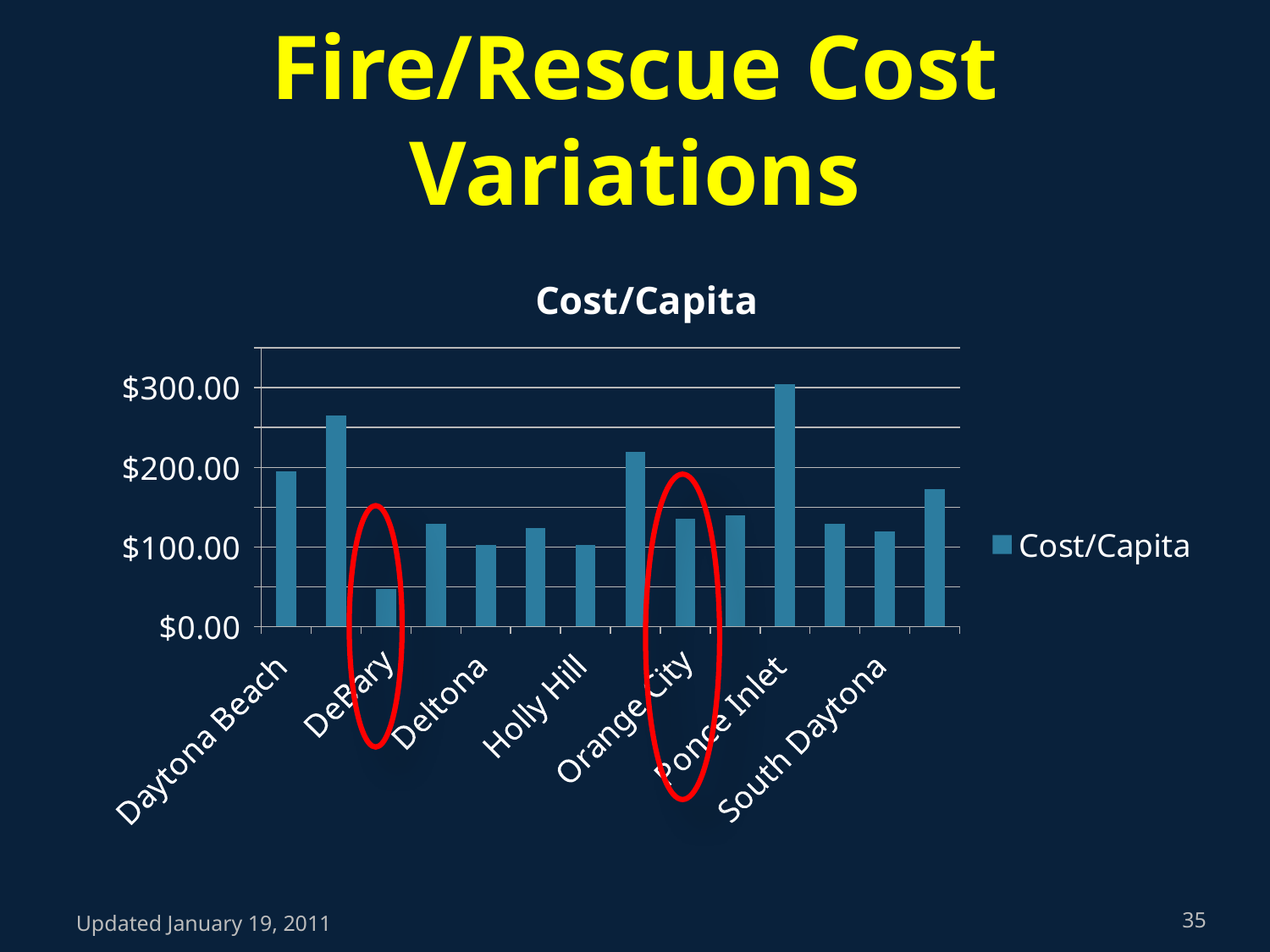
How many bars are plotted in the chart? 14 Which category has the lowest Cost/Capita? DeBary Is the value for Daytona Beach greater or less than $100.00? greater How many series does the legend list? 1 Is the value for Ponce Inlet greater or less than $200.00? greater Is the value for DeBary greater or less than $100.00? less Which is larger, the Cost/Capita for Daytona Beach or for Orange City? Daytona Beach Which two category labels are circled in red on the chart? DeBary and Orange City What is the title of the chart? Cost/Capita What kind of chart is shown on the slide? bar chart Which category has the highest Cost/Capita? Ponce Inlet